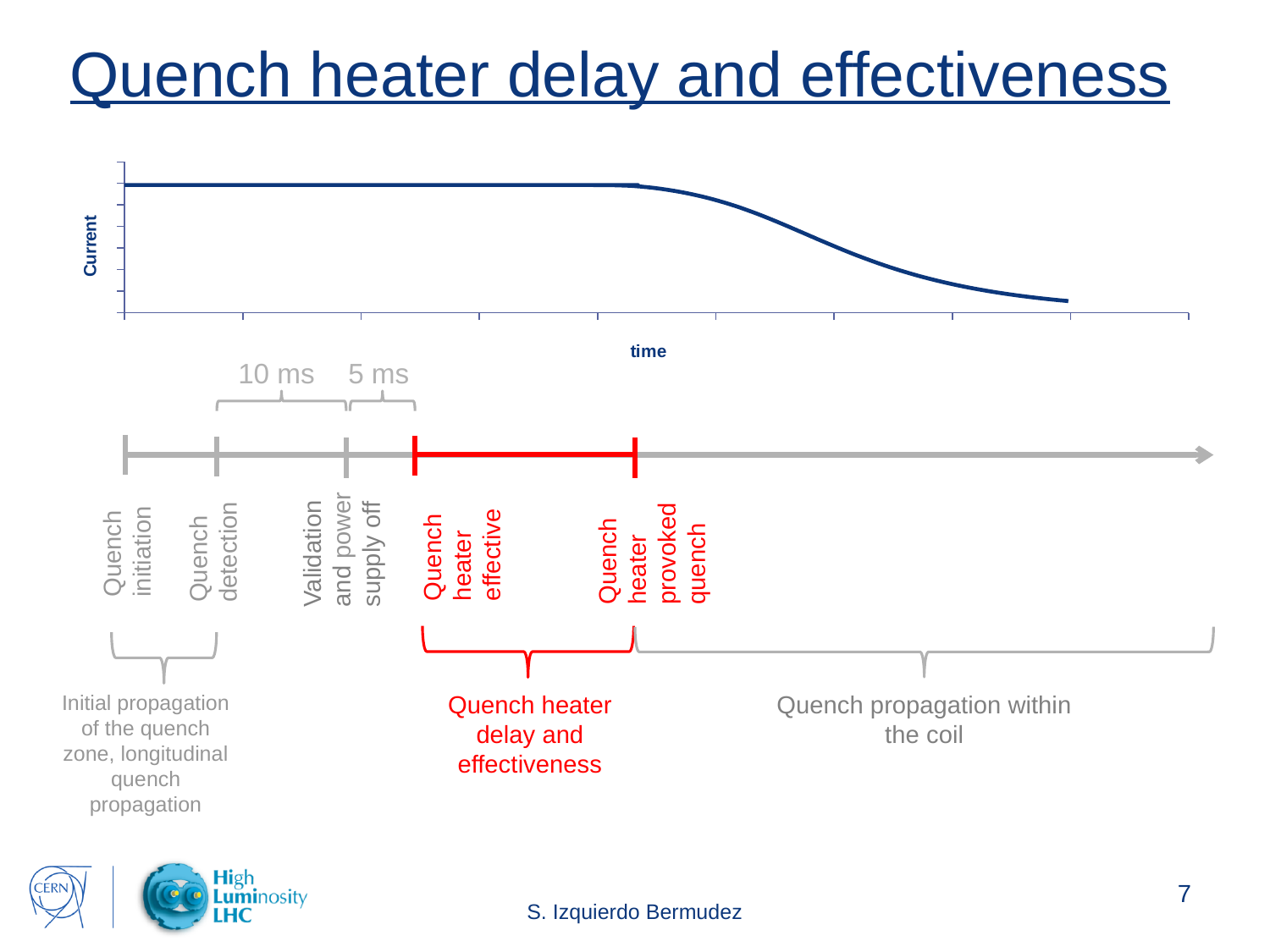
How many lines are plotted on the chart? 1 What is the label on the horizontal axis of the chart? time Does the current rise or fall as time increases along the x axis? fall In the left part of the chart, before the curve starts to drop, is the current constant or changing? constant What is the label on the vertical axis of the chart? Current What kind of chart is shown at the top of the slide? line chart